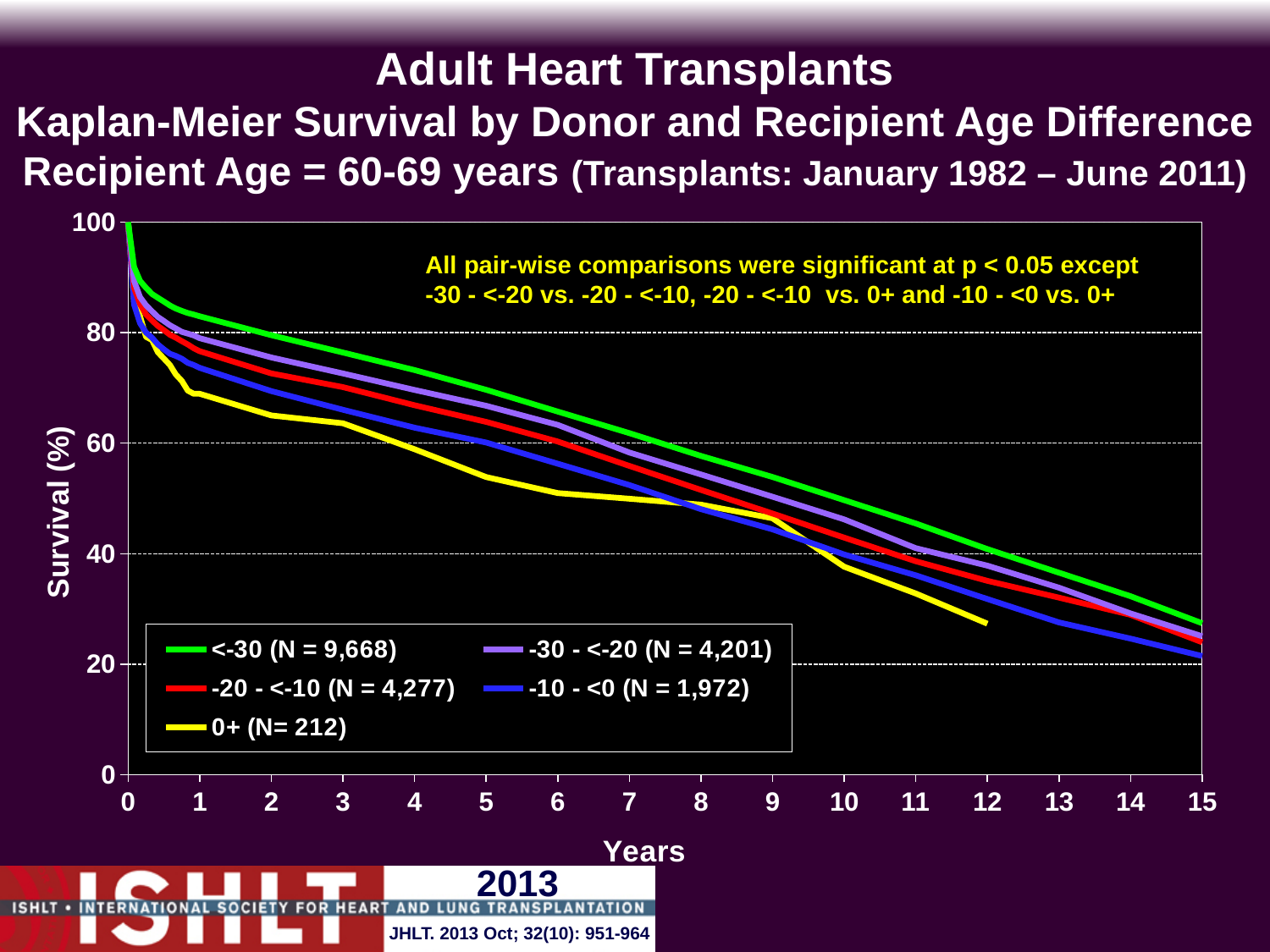
Which series has the lowest survival at year 5? 0+ (N= 212) Do the survival curves rise or fall as the years increase? Fall Is the survival for the -30 - <-20 series at year 10 greater or less than 60? less At year 3, which series has higher survival: <-30 or 0+? <-30 Is the survival for the 0+ series at year 10 greater or less than 40? less Is the survival for the <-30 series at year 5 greater or less than 60? greater How many series does the legend list? 5 What kind of chart is shown on the slide? Line chart What is the N value shown in the legend for the <-30 series? 9,668 Which series has the highest survival at year 5? <-30 (N = 9,668) What is the label of the y-axis? Survival (%)